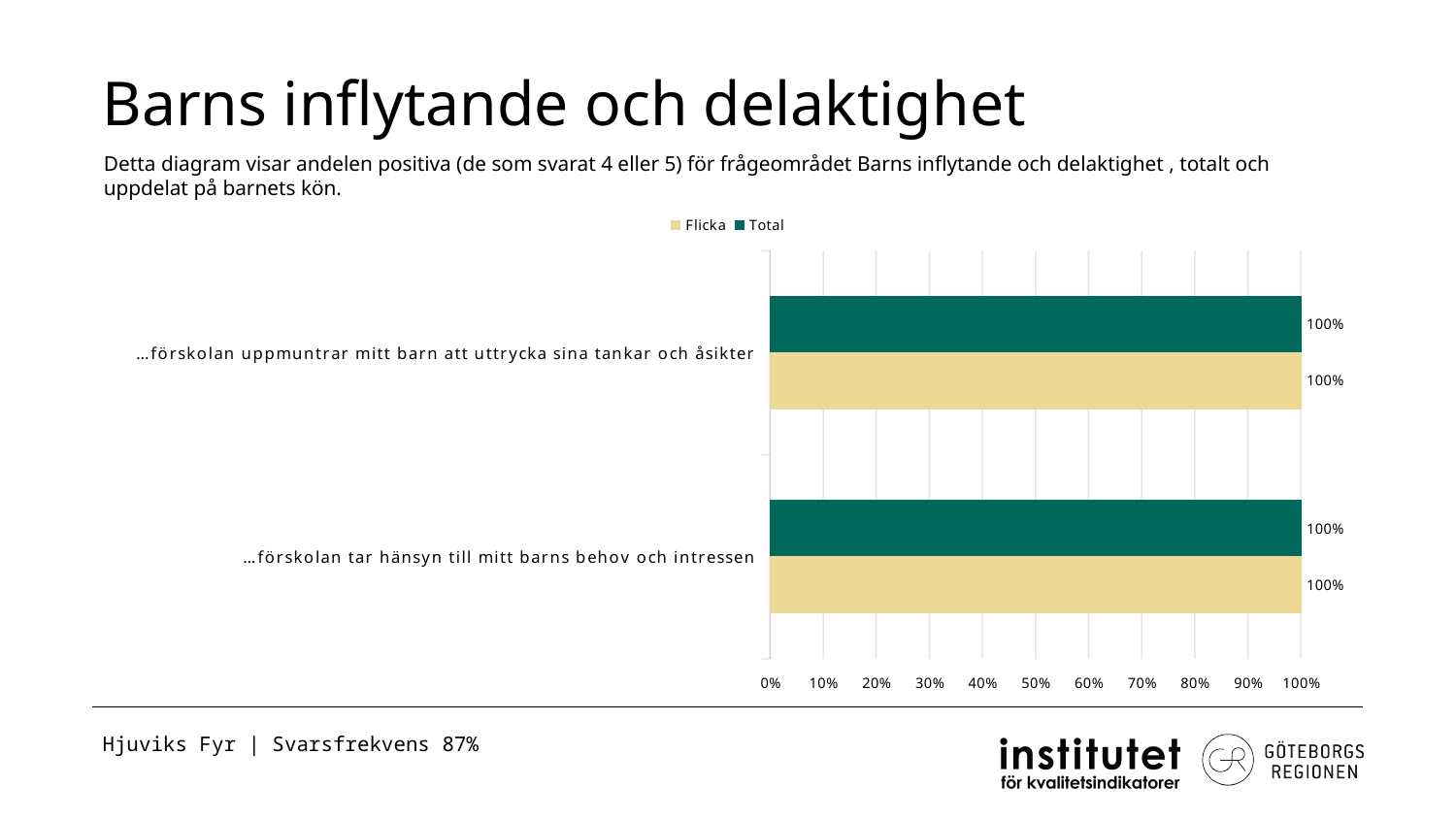
What is the Total value for "…förskolan uppmuntrar mitt barn att uttrycka sina tankar och åsikter"? 100% What kind of chart is shown on the slide? bar chart What is the Flicka value for "…förskolan uppmuntrar mitt barn att uttrycka sina tankar och åsikter"? 100% How many series does the legend list? 2 What is the Total value for "…förskolan tar hänsyn till mitt barns behov och intressen"? 100% What is the highest value shown on the x axis? 100% How many categories (statements) are plotted in the chart? 2 What is the difference between the Flicka and Total values for "…förskolan tar hänsyn till mitt barns behov och intressen"? 0% Which series does the legend list? Flicka and Total What is the Flicka value for "…förskolan tar hänsyn till mitt barns behov och intressen"? 100% Is the Total value for "…förskolan uppmuntrar mitt barn att uttrycka sina tankar och åsikter" greater or less than 90%? greater Which colour represents the Total series in the chart? dark green